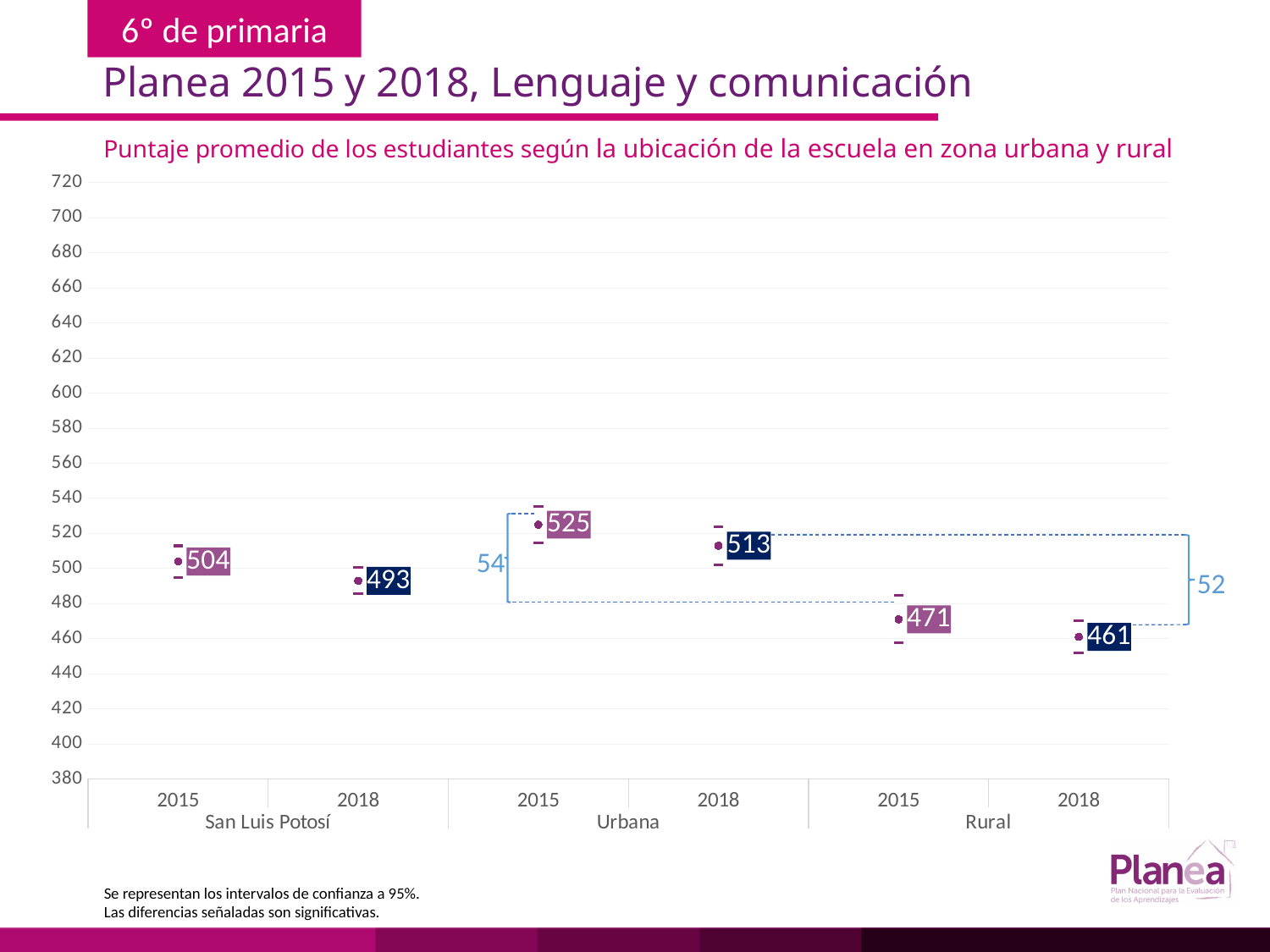
Which group and year has the lowest average score on the chart? Rural 2018 (461) What is the average score for San Luis Potosí in 2015? 504 How many data points are plotted on the chart? 6 Which group and year has the highest average score on the chart? Urbana 2015 (525) What is the average score for Rural schools in 2015? 471 What is the difference between the San Luis Potosí scores in 2015 and 2018? 11 What is the subtitle of the chart? Puntaje promedio de los estudiantes según la ubicación de la escuela en zona urbana y rural What is the difference between the Urbana and Rural scores in 2018? 52 What is the difference between the Urbana and Rural scores in 2015? 54 Did the Urbana score rise or fall from 2015 to 2018? Fall Which is larger, the San Luis Potosí score in 2018 or the Rural score in 2015? San Luis Potosí 2018 (493) What is the average score for Urbana schools in 2018? 513